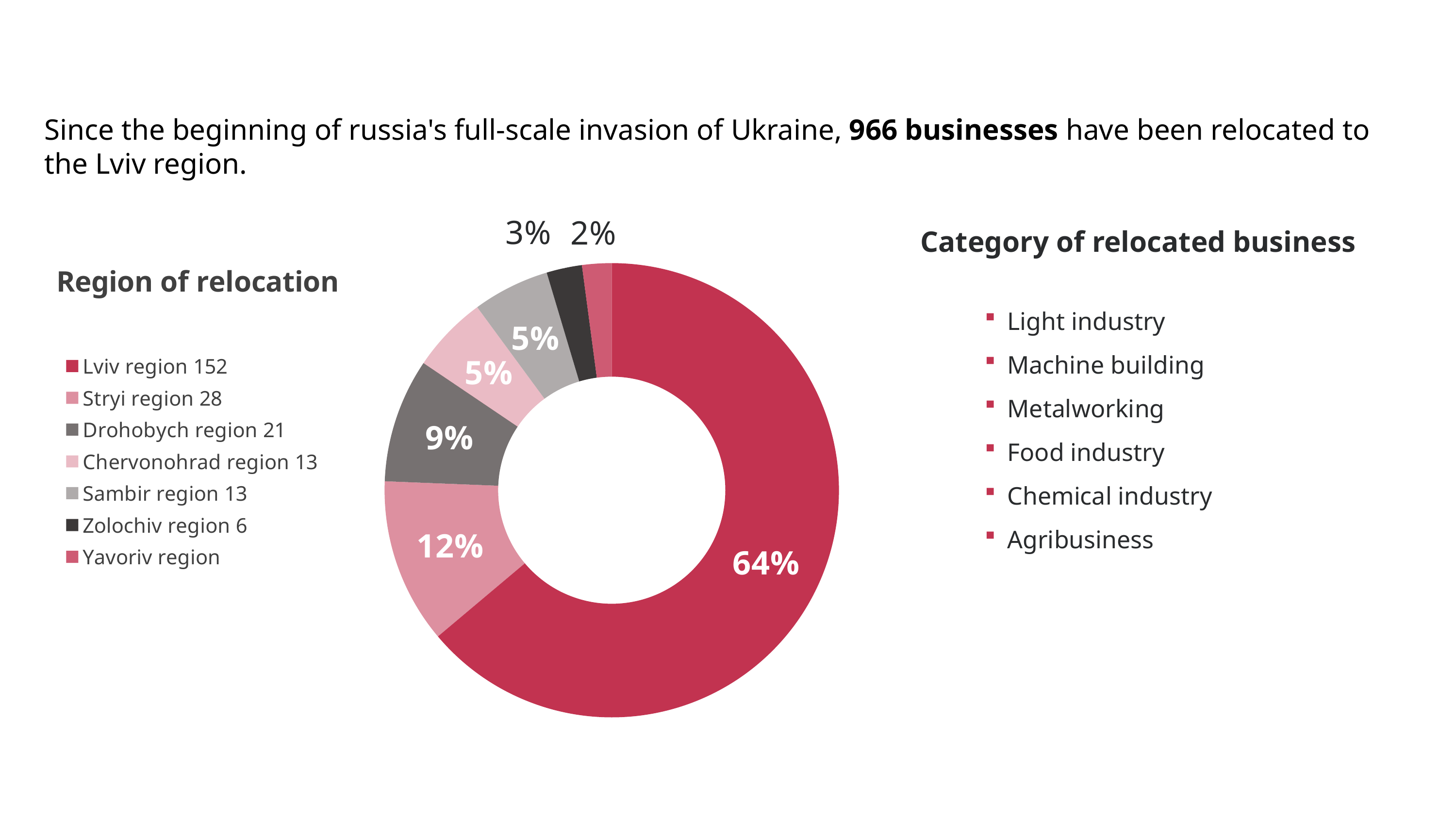
In the "Region of relocation" chart, what is the difference between the number of businesses for the Lviv region (152) and the Stryi region (28)? 124 What percentage share does the Stryi region slice have in the "Region of relocation" chart? 12% How many regions are shown in the "Region of relocation" chart? 7 According to the legend of the "Region of relocation" chart, how many businesses were relocated to the Sambir region? 13 What kind of chart is shown under the title "Region of relocation"? Doughnut (pie) chart What percentage share does the Drohobych region slice have in the "Region of relocation" chart? 9% In the "Region of relocation" chart, which has the larger share: Stryi region or Drohobych region? Stryi region Which region has the largest slice in the "Region of relocation" chart? Lviv region What is the title of the doughnut chart on the slide? Region of relocation According to the legend of the "Region of relocation" chart, how many businesses were relocated to the Zolochiv region? 6 What percentage share does the Lviv region slice have in the "Region of relocation" chart? 64% Which region has the smallest slice in the "Region of relocation" chart? Yavoriv region